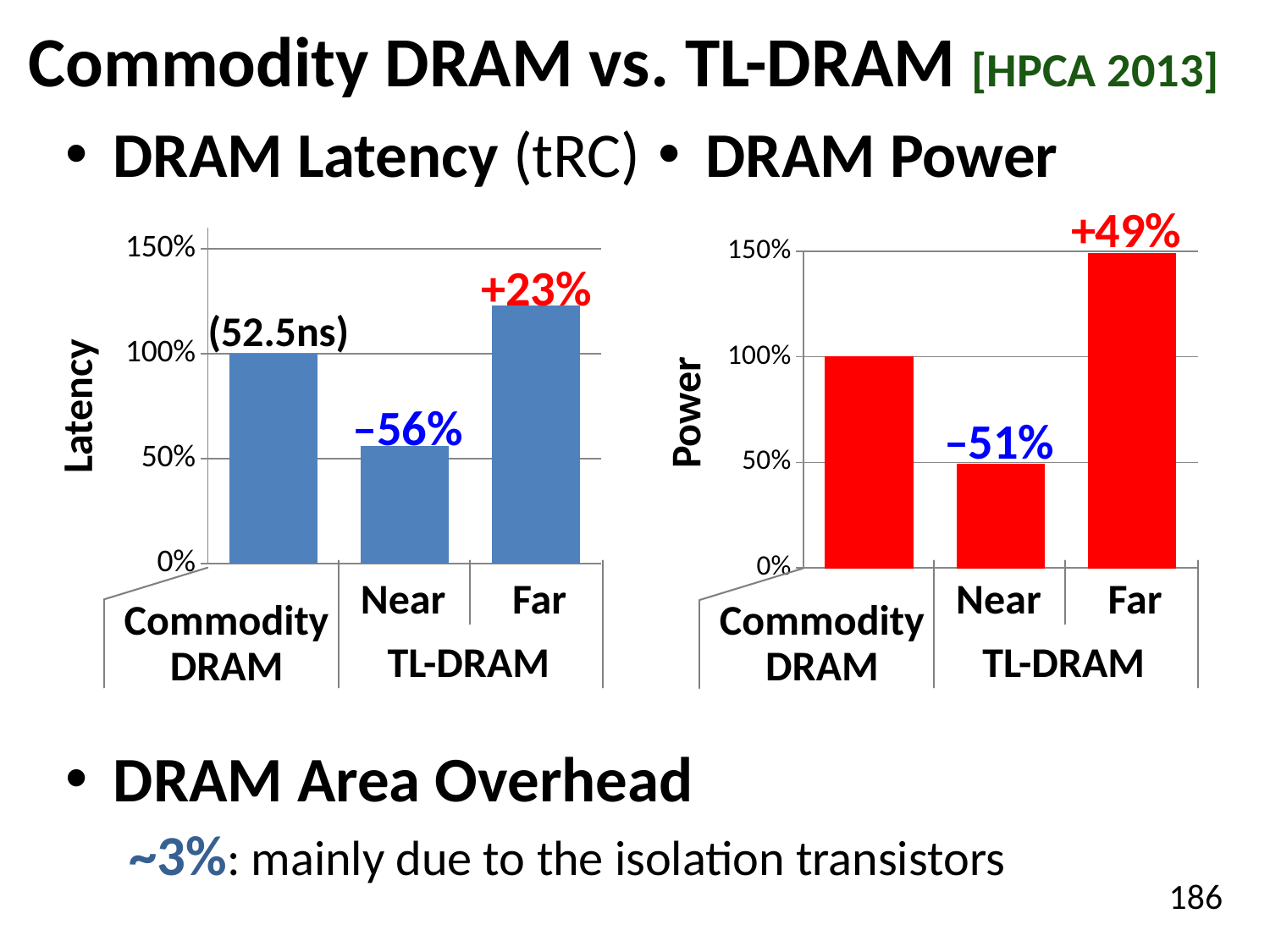
In the DRAM Latency chart, which bar is the lowest? TL-DRAM Near In the DRAM Latency chart, what is the latency value for Commodity DRAM? 100% In the DRAM Latency chart, is the value for TL-DRAM Far greater or less than 100%? greater In the DRAM Power chart, which bar is the highest? TL-DRAM Far In the DRAM Latency chart, what percentage change is labeled on the TL-DRAM Near bar? –56% In the DRAM Power chart, what percentage change is labeled on the TL-DRAM Far bar? +49% What type of chart is the DRAM Latency chart? Bar chart In the DRAM Power chart, is the value for TL-DRAM Near greater or less than 100%? less In the DRAM Power chart, what percentage change is labeled on the TL-DRAM Near bar? –51% In the DRAM Latency chart, what percentage change is labeled on the TL-DRAM Far bar? +23% In the DRAM Latency chart, what absolute latency is printed above the Commodity DRAM bar? 52.5ns How many bars are plotted in the DRAM Power chart? 3